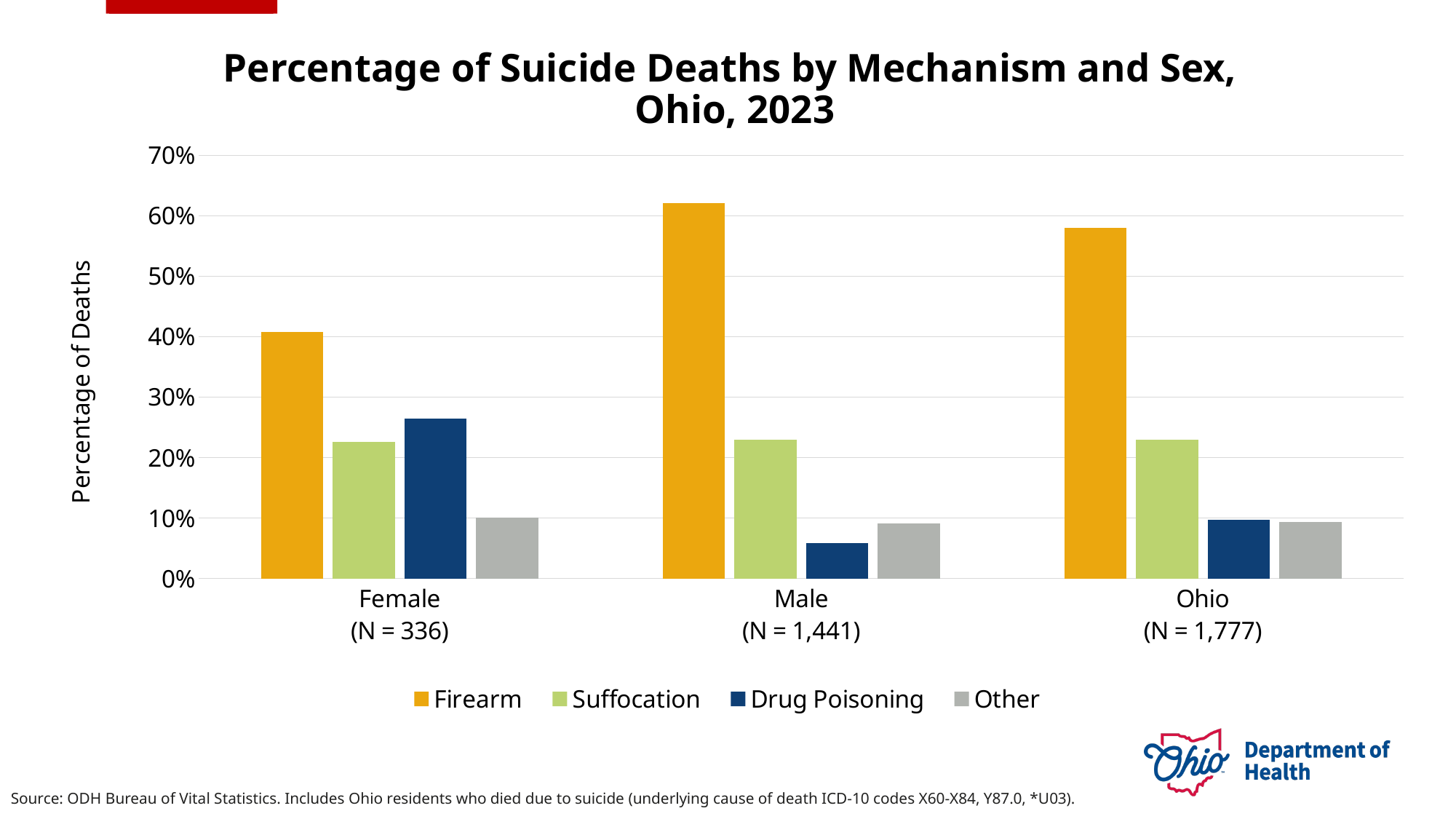
Which mechanism has the lowest percentage of suicide deaths for Males? Drug Poisoning Which mechanism has the lowest percentage of suicide deaths for Females? Other Is the Drug Poisoning value for Females greater or less than 20%? greater How many series does the legend list? 4 How many categories are shown on the x axis? 3 Is the Drug Poisoning value for Males greater or less than 10%? less What is the N shown for the Male category? N = 1,441 For Females, which is larger: the Drug Poisoning percentage or the Suffocation percentage? Drug Poisoning What kind of chart is shown on the slide? Bar chart Which group has the larger Firearm percentage, Female or Male? Male Which mechanism has the highest percentage of suicide deaths for Males? Firearm Is the Firearm value for Males greater or less than 50%? greater